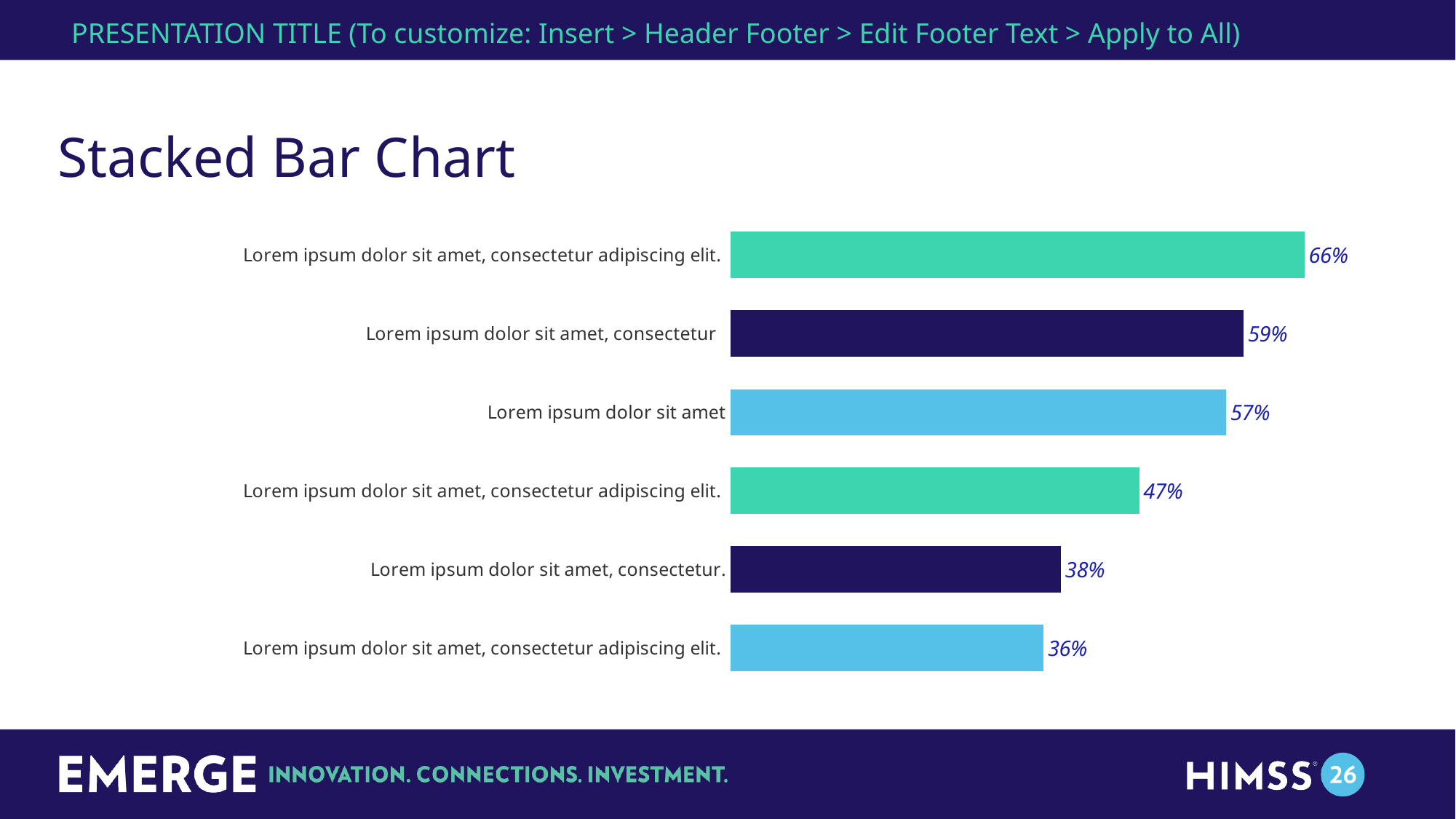
What is the lowest value shown in the chart? 36% Which is larger, the fourth bar from the top or the fifth bar from the top? The fourth bar (47%) What is the title of the chart on the slide? Stacked Bar Chart What kind of chart is shown on the slide? Bar chart What is the value of the fifth bar from the top? 38% What is the difference between the top bar (66%) and the bottom bar (36%)? 30% What is the value of the second bar from the top, labelled 'Lorem ipsum dolor sit amet, consectetur'? 59% What is the value of the fourth bar from the top? 47% How many bars does the chart contain? 6 Do the bar values increase or decrease going from the top bar to the bottom bar? Decrease What is the highest value shown in the chart? 66% What is the value of the bar labelled 'Lorem ipsum dolor sit amet' (third from the top)? 57%